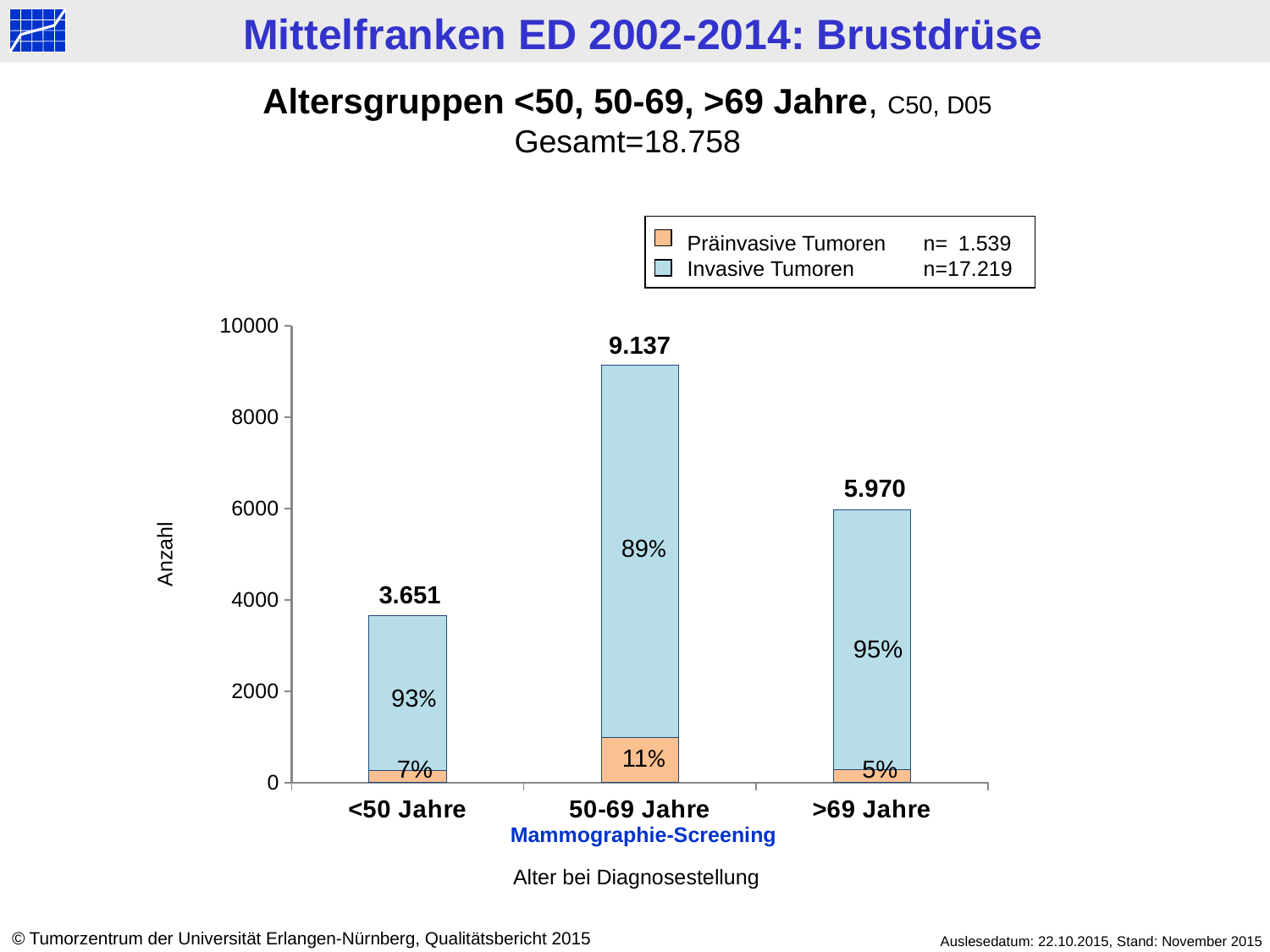
What percentage of the >69 Jahre bar is made up of Invasive Tumoren? 95% According to the legend, what is the n for Invasive Tumoren? n=17.219 What is the difference between the total for 50-69 Jahre and the total for >69 Jahre? 3.167 How many age groups are shown on the x axis? 3 What is the total number of cases shown for the <50 Jahre age group? 3.651 Which age group has the lowest total number of cases? <50 Jahre Which is larger, the total for >69 Jahre or the total for <50 Jahre? >69 Jahre What kind of chart is shown on the slide? Stacked bar chart What is the total number of cases shown for the 50-69 Jahre age group? 9.137 Which age group has the highest total number of cases? 50-69 Jahre What percentage of the 50-69 Jahre bar is made up of Präinvasive Tumoren? 11% How many series does the legend list? 2